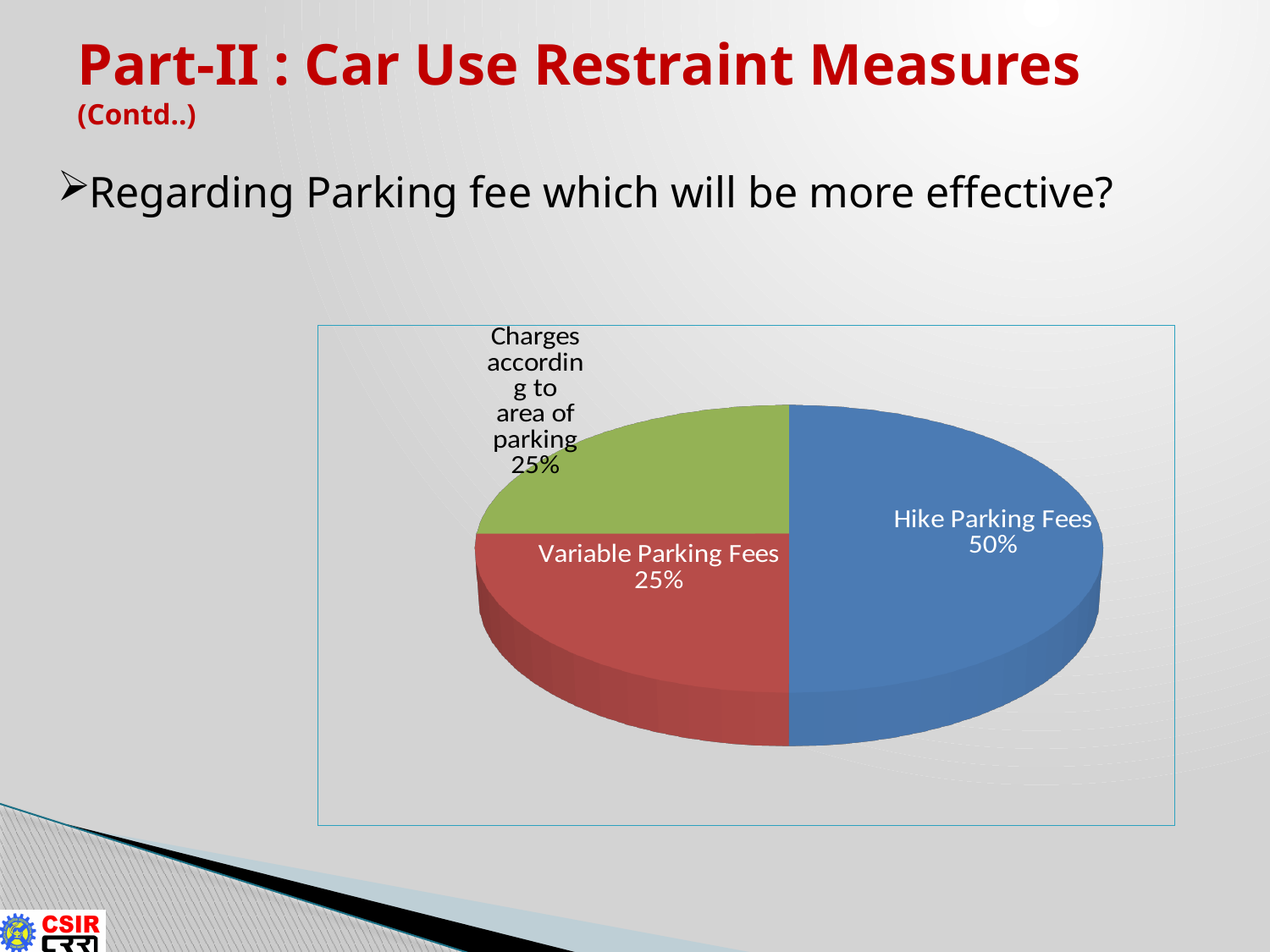
How many slices does the pie chart have? 3 What share of the pie does Variable Parking Fees have? 25% What share of the pie does Charges according to area of parking have? 25% What colour is the Variable Parking Fees slice? Red What colour is the Hike Parking Fees slice? Blue Which is larger, the slice for Hike Parking Fees or the slice for Variable Parking Fees? Hike Parking Fees Which category has the largest slice of the pie? Hike Parking Fees What is the combined share of Variable Parking Fees and Charges according to area of parking? 50% What kind of chart is shown on the slide? Pie chart What share of the pie does Hike Parking Fees have? 50% What is the difference in percentage points between Hike Parking Fees and Variable Parking Fees? 25%